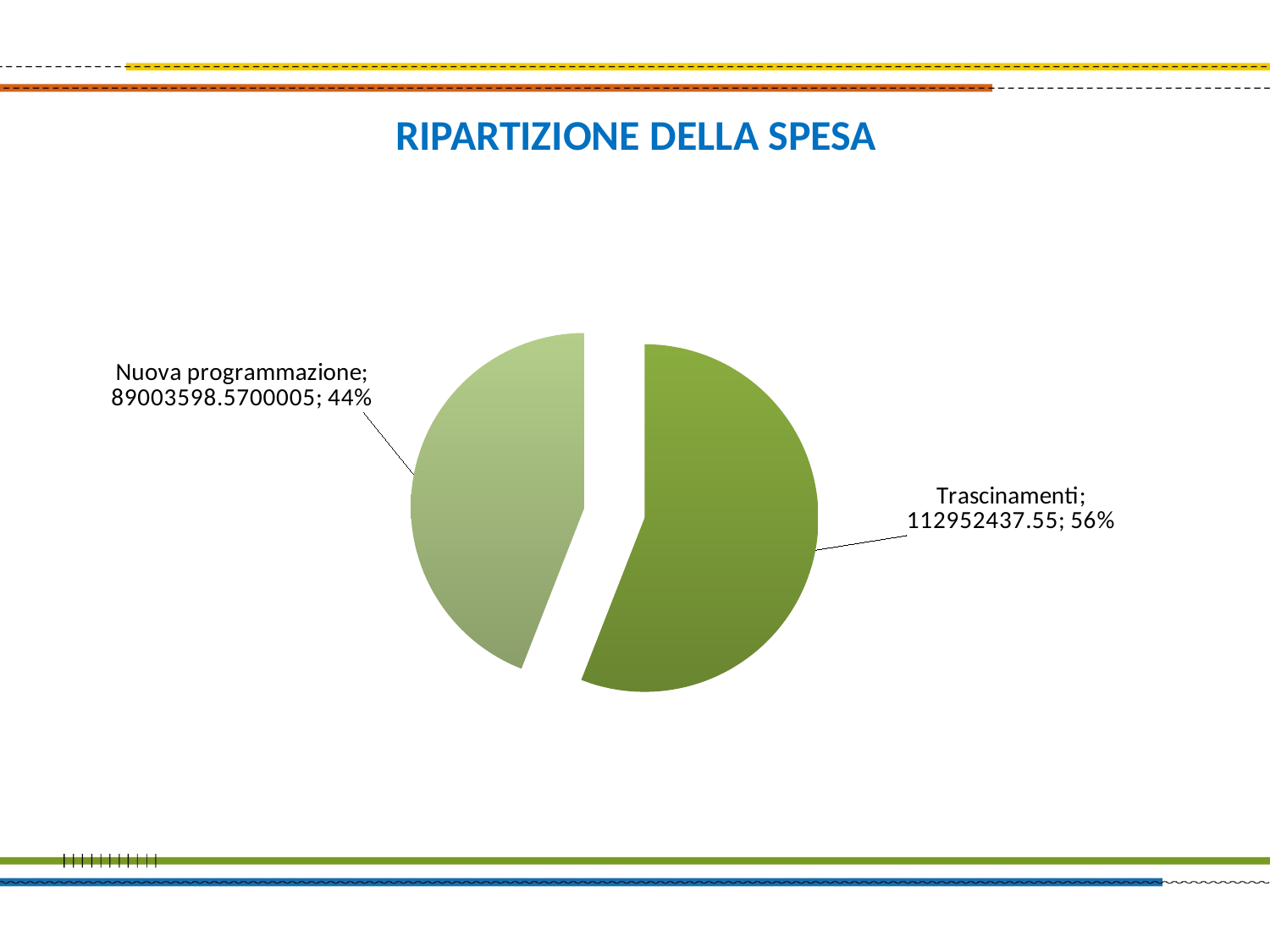
What kind of chart is shown on the slide? pie chart What is the value shown for Trascinamenti? 112952437.55 What is the value shown for Nuova programmazione? 89003598.5700005 Which slice is the largest? Trascinamenti Which slice is the smallest? Nuova programmazione Which is larger, Trascinamenti or Nuova programmazione? Trascinamenti Which slice is drawn in the darker green? Trascinamenti What is the title of the chart? RIPARTIZIONE DELLA SPESA By how many percentage points does the share of Trascinamenti exceed that of Nuova programmazione? 12 What share of the pie does Trascinamenti represent? 56% What share of the pie does Nuova programmazione represent? 44% How many slices does the pie chart have? 2